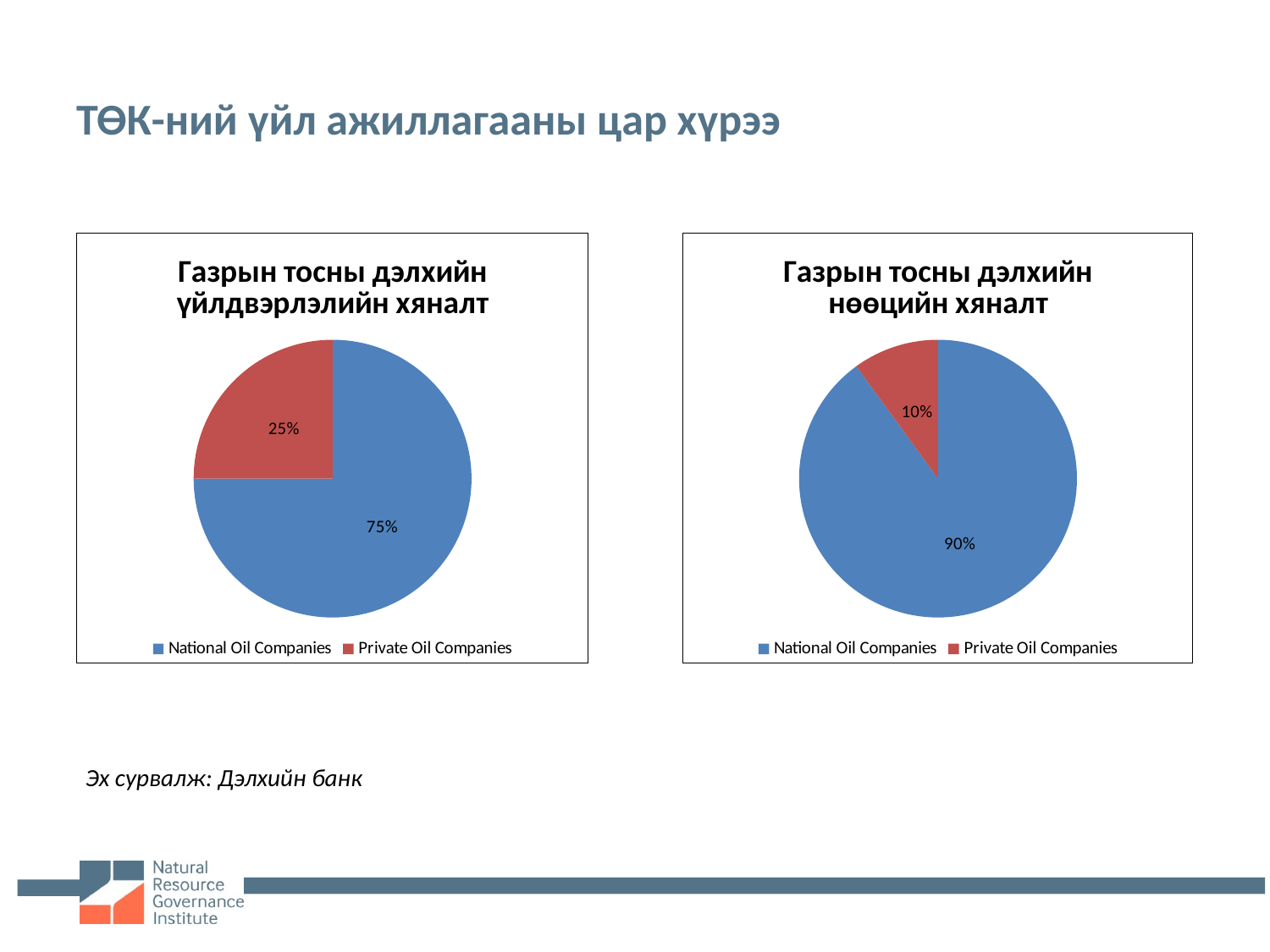
Is the Private Oil Companies share larger in the left chart or in the right chart? Left chart In the right chart, what is the difference between the National Oil Companies share and the Private Oil Companies share? 80% In the right chart, what colour is the slice for National Oil Companies? Blue What type of chart is the right chart (Газрын тосны дэлхийн нөөцийн хяналт)? Pie chart In the left chart, which category has the largest slice? National Oil Companies How many categories does the legend of the left chart list? 2 In the left chart (Газрын тосны дэлхийн үйлдвэрлэлийн хяналт), what share do Private Oil Companies hold? 25% In the right chart (Газрын тосны дэлхийн нөөцийн хяналт), what share do Private Oil Companies hold? 10% In the right chart (Газрын тосны дэлхийн нөөцийн хяналт), what share do National Oil Companies hold? 90% In the left chart (Газрын тосны дэлхийн үйлдвэрлэлийн хяналт), what share do National Oil Companies hold? 75% In the left chart, what is the difference between the National Oil Companies share and the Private Oil Companies share? 50% In the right chart, which category has the smallest slice? Private Oil Companies